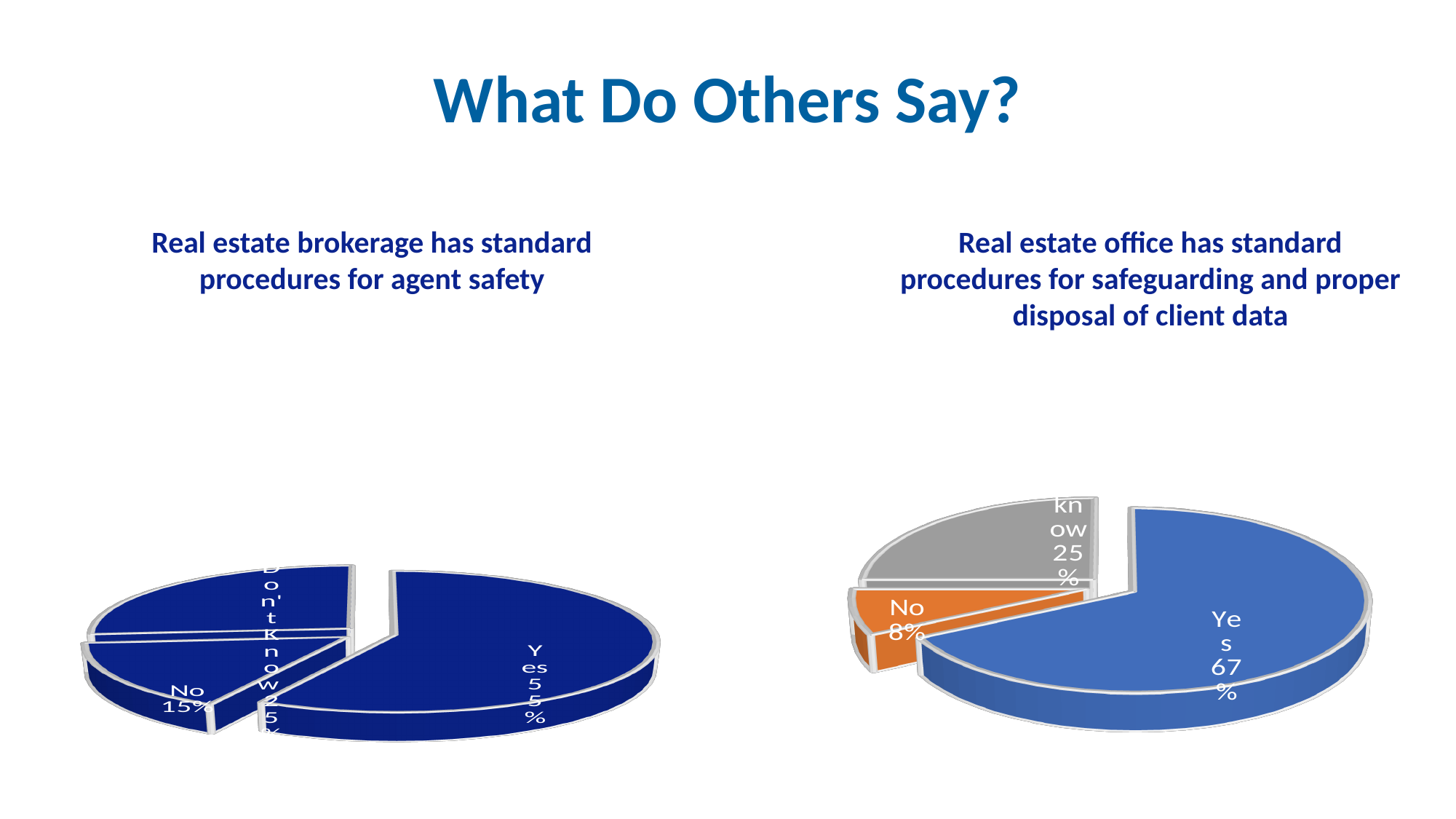
In the right-hand chart about safeguarding client data, which response has the smallest share? No In the right-hand chart about safeguarding client data, how many percentage points larger is Yes than No? 59 In the chart titled "Real estate office has standard procedures for safeguarding and proper disposal of client data", what percentage answered Don't know? 25% In the chart titled "Real estate brokerage has standard procedures for agent safety", what percentage answered Yes? 55% In the right-hand chart about safeguarding client data, which response has the largest share? Yes In the chart titled "Real estate office has standard procedures for safeguarding and proper disposal of client data", what percentage answered No? 8% In the left-hand chart about agent safety, which is larger, Yes or No? Yes In the chart titled "Real estate office has standard procedures for safeguarding and proper disposal of client data", what percentage answered Yes? 67% What kind of chart is used on this slide? Pie chart In the left-hand chart about agent safety, which response has the largest share? Yes In the chart titled "Real estate brokerage has standard procedures for agent safety", what percentage answered No? 15% How many slices does the right-hand chart about safeguarding client data have? 3